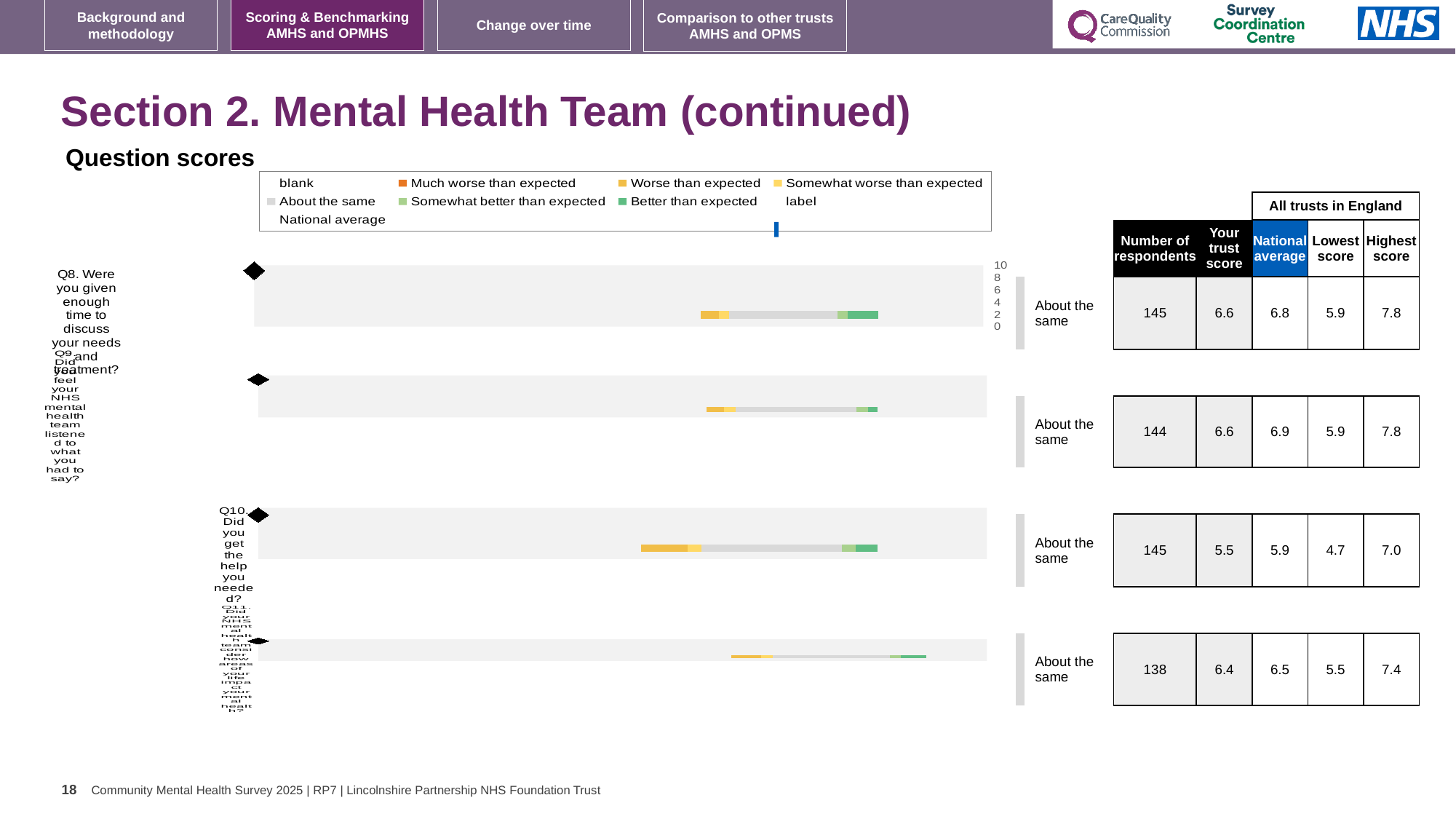
Which question has the lowest number of respondents on this slide? Q11 What is the 'Your trust score' for Q8 (Were you given enough time to discuss your needs and treatment?)? 6.6 How many questions (Q8 to Q11) have a bar plotted on the slide? 4 What is the national average score for Q9 (Did you feel your NHS mental health team listened to what you had to say?)? 6.9 How many respondents answered Q11 (Did your NHS mental health team consider how areas of your life impact your mental health?)? 138 In the legend, what colour represents 'Better than expected'? green For Q8, which is larger: the trust score or the national average? National average What kind of chart is used to show the question scores for Q8 to Q11? bar chart For Q10, what is the difference between the national average and the trust score? 0.4 In the legend, what colour represents 'Much worse than expected'? orange What is the highest score among all trusts in England for Q10 (Did you get the help you needed?)? 7.0 Which question has the lowest 'Your trust score' on this slide? Q10